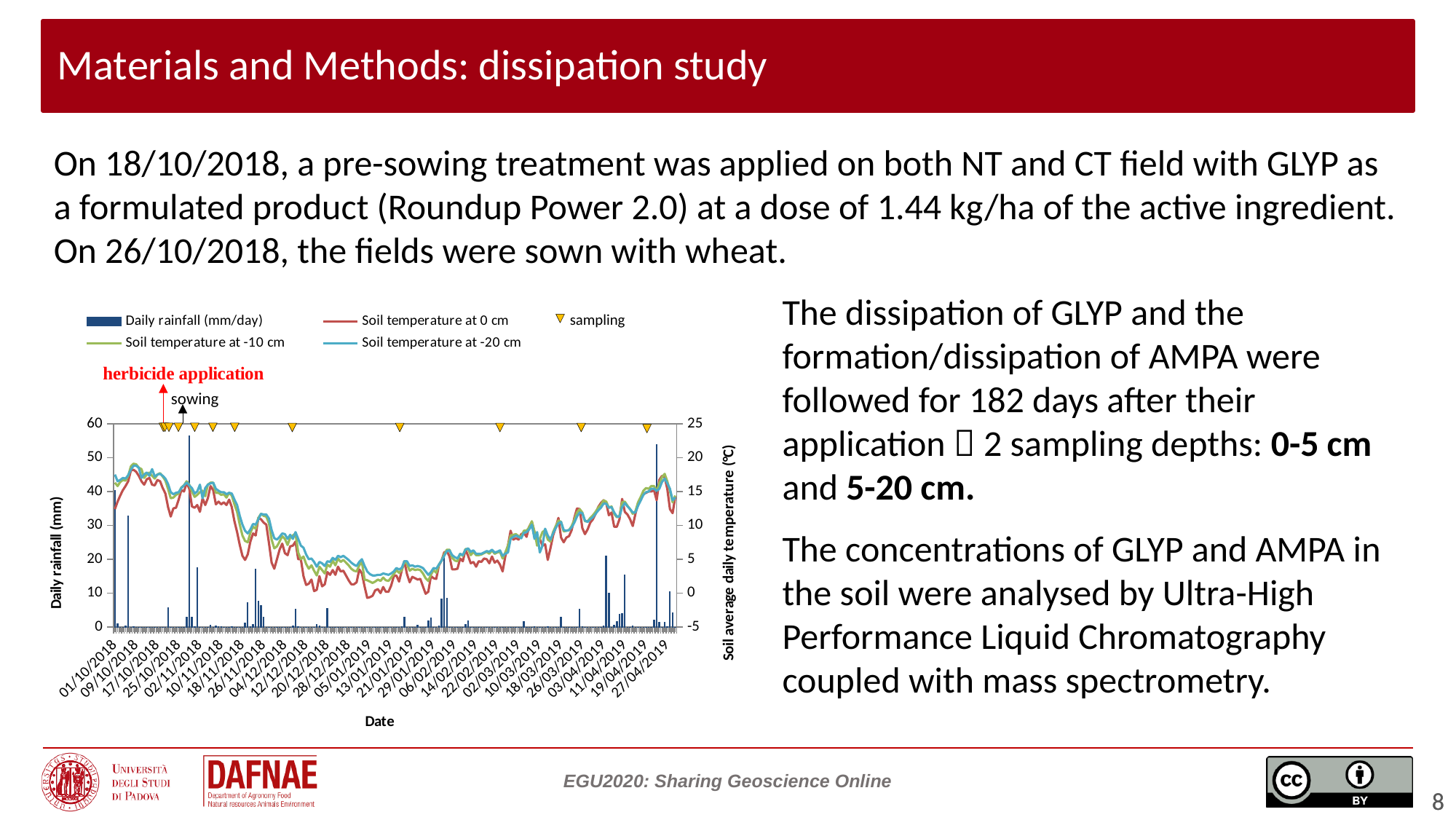
What is the minimum value shown on the right (soil temperature) axis? -5 What is the title of the right vertical axis of the chart? Soil average daily temperature (°C) What kind of chart is shown on the slide? Combined bar and line chart Is the tallest daily rainfall bar greater or less than 40 mm? greater What is the title of the left vertical axis of the chart? Daily rainfall (mm) Around 26/11/2018, which is higher: the soil temperature at 0 cm or at -20 cm? Soil temperature at -20 cm What is the maximum value shown on the left (daily rainfall) axis? 60 How many entries does the chart legend list? 5 How many sampling markers (triangles) are shown along the top of the chart? 10 How do the soil temperature lines change from October 2018 to January 2019? They fall Is the soil temperature at 0 cm in early January 2019 greater or less than 5 °C? less